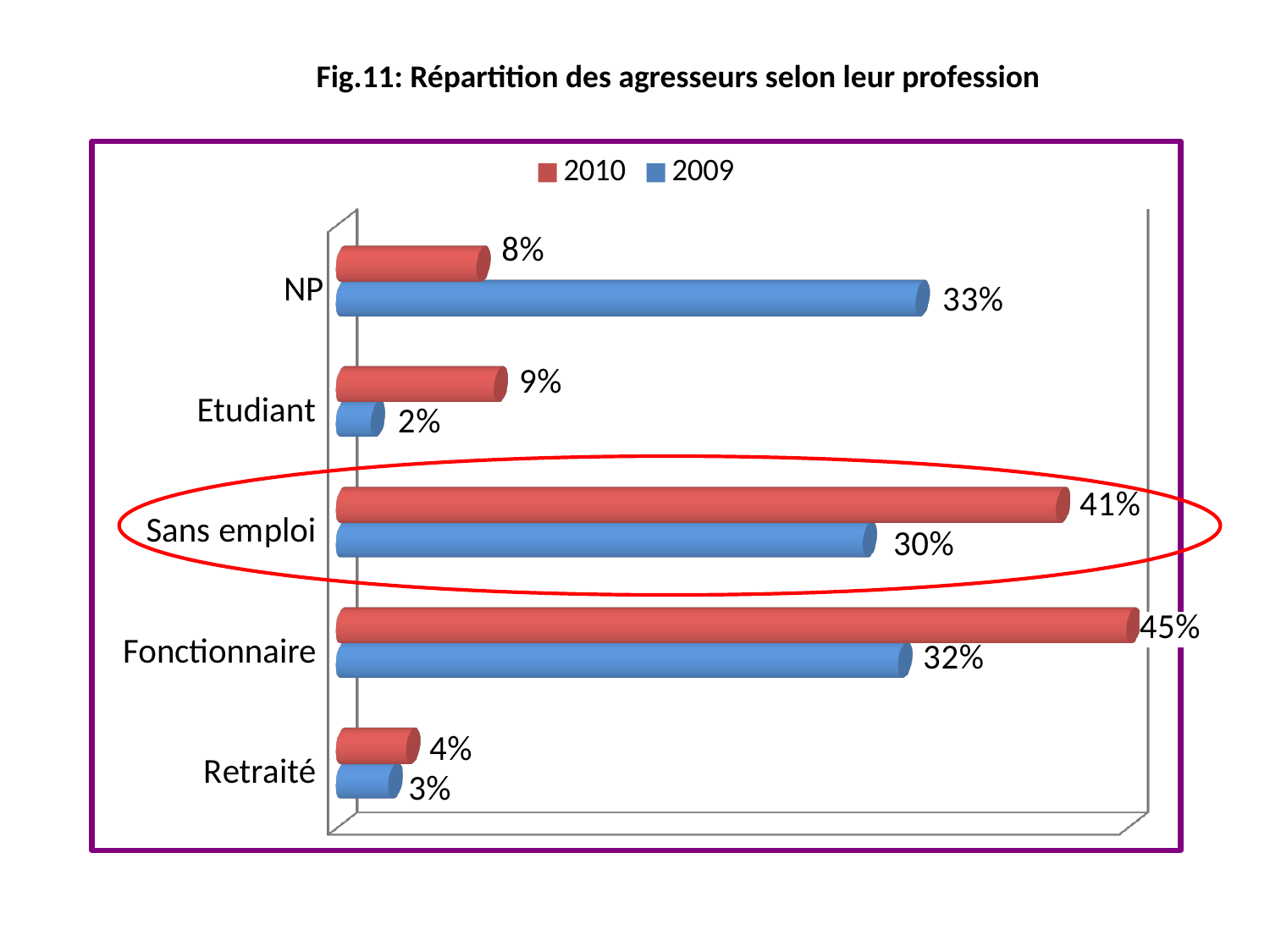
Which is larger for NP: the 2010 value or the 2009 value? 2009 How many profession categories are shown on the chart? 5 What is the 2010 value for Sans emploi? 41% How many series does the legend list? 2 What is the difference between the 2009 values for NP and Sans emploi? 3% Which category has the lowest 2009 value? Etudiant Which category has the highest 2010 value? Fonctionnaire What is the 2009 value for Etudiant? 2% What is the 2009 value for NP? 33% What is the difference between the 2010 and 2009 values for Fonctionnaire? 13% What is the 2010 value for Retraité? 4% What kind of chart is shown on the slide? Bar chart